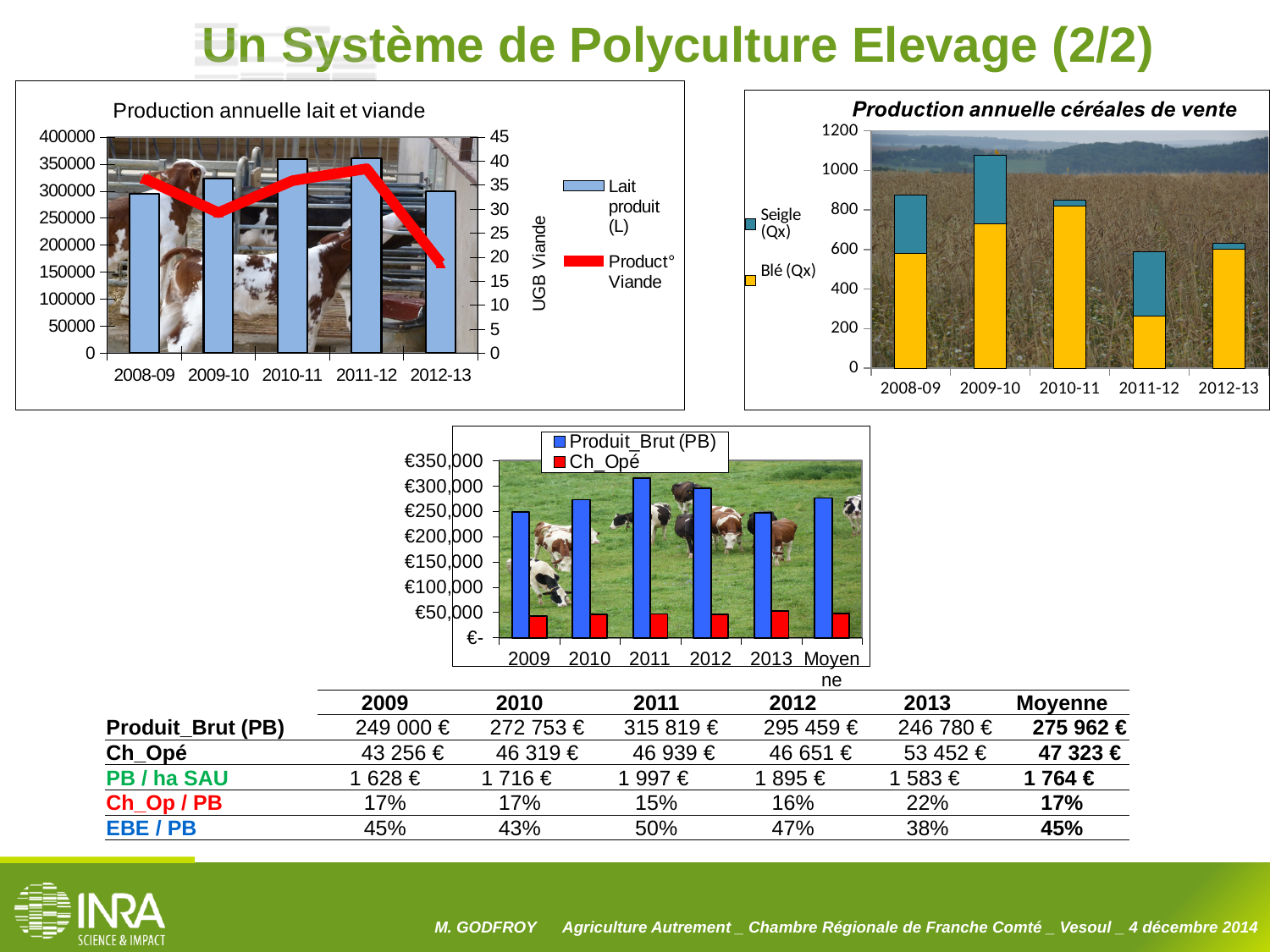
In the 'Production annuelle céréales de vente' chart, which year has the highest total production? 2009-10 In the 'Production annuelle céréales de vente' chart, is the total stacked value for 2009-10 greater or less than 1000? greater What is the label of the right-hand vertical axis in the 'Production annuelle lait et viande' chart? UGB Viande How many years are shown on the x axis of the 'Production annuelle lait et viande' chart? 5 How many series does the legend of the 'Production annuelle céréales de vente' chart list? 2 In the 'Production annuelle lait et viande' chart, which year has the lowest Product° Viande value? 2012-13 In the 'Production annuelle céréales de vente' chart, which year has the lowest Blé (Qx) value? 2011-12 In the 'Production annuelle lait et viande' chart, does the Product° Viande line rise or fall from 2011-12 to 2012-13? fall What kind of chart is the 'Production annuelle céréales de vente' chart? Stacked bar chart In the bottom chart (Produit_Brut (PB) and Ch_Opé), which is larger: Produit_Brut (PB) for 2010 or for 2012? 2012 In the 'Production annuelle lait et viande' chart, is the Lait produit (L) value for 2010-11 greater or less than 350000? greater In the bottom chart (Produit_Brut (PB) and Ch_Opé), which year has the highest Produit_Brut (PB) value? 2011